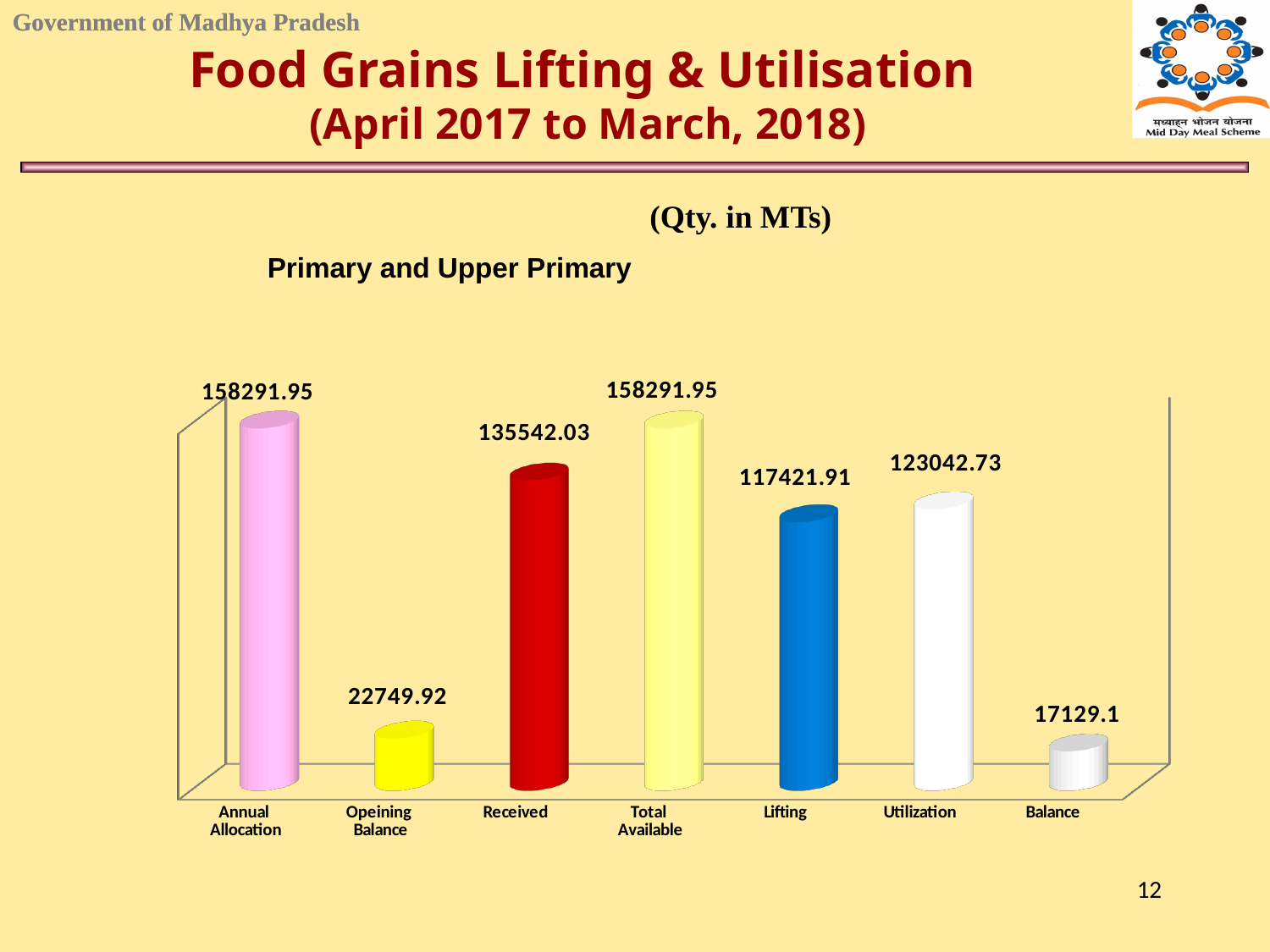
What is the value for Utilization? 123042.73 Which category has the lowest value? Balance What is the difference between Received and Opeining Balance? 112792.11 What is the value for Received? 135542.03 What is the value for Annual Allocation? 158291.95 What is the value for Lifting? 117421.91 What is the value for Balance? 17129.1 What is the difference between Utilization and Lifting? 5620.82 What kind of chart is shown on the slide? Bar chart How many categories are shown on the chart? 7 Which is larger, Utilization or Lifting? Utilization What unit is stated for the quantities on the chart? MTs